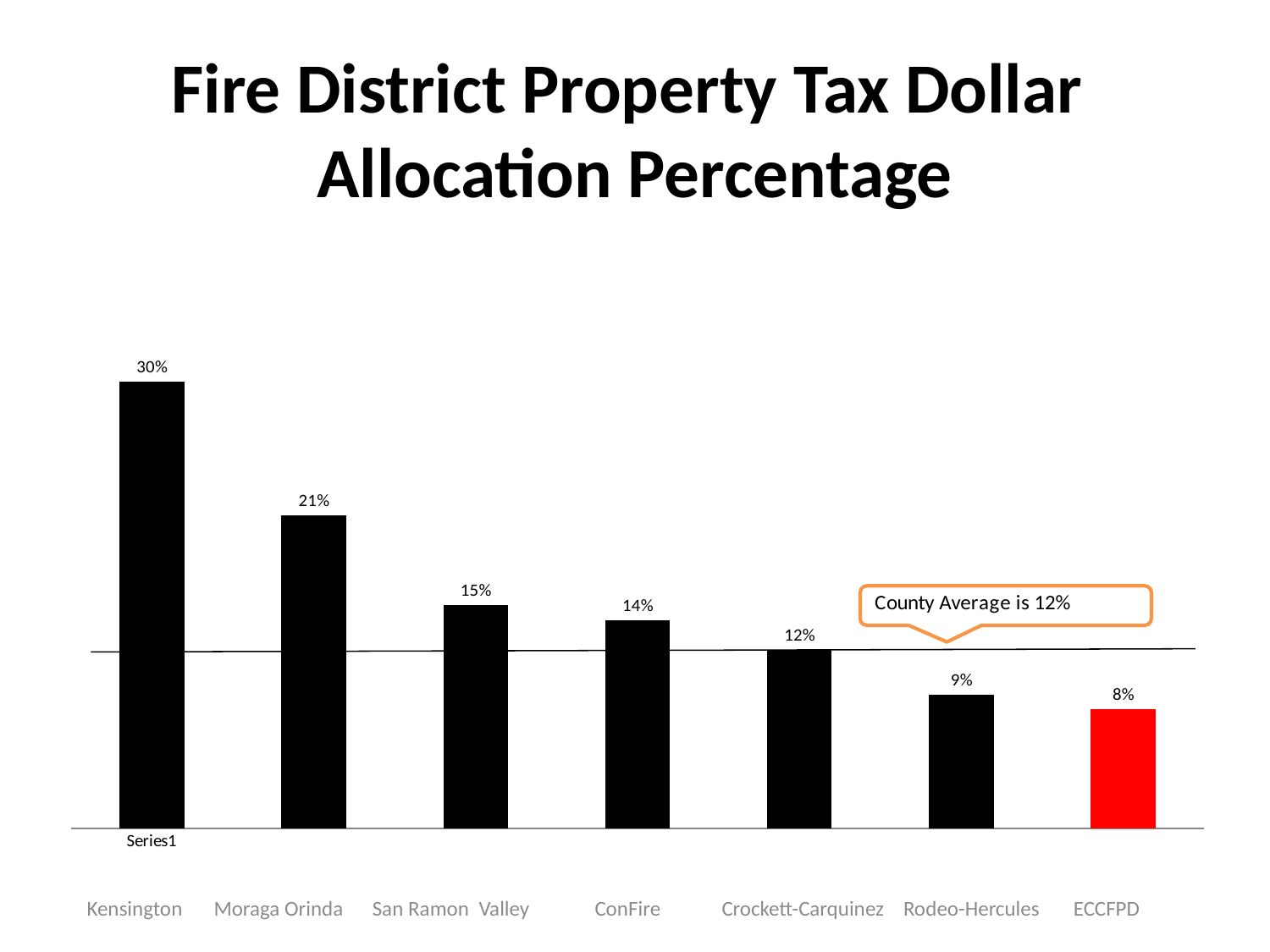
Which fire district has the highest allocation percentage? Kensington What is the allocation percentage for Moraga Orinda? 21% Which fire district has the lowest allocation percentage? ECCFPD What is the allocation percentage for Crockett-Carquinez? 12% What is the allocation percentage for ECCFPD? 8% How many fire districts are shown in the chart? 7 Which has a larger allocation percentage, Rodeo-Hercules or Moraga Orinda? Moraga Orinda According to the callout on the chart, what is the county average allocation percentage? 12% What is the difference between the allocation percentages for San Ramon Valley and ConFire? 1% What kind of chart is shown on the slide? Bar chart What is the property tax dollar allocation percentage for Kensington? 30% What is the difference between the allocation percentages for Kensington and ECCFPD? 22%